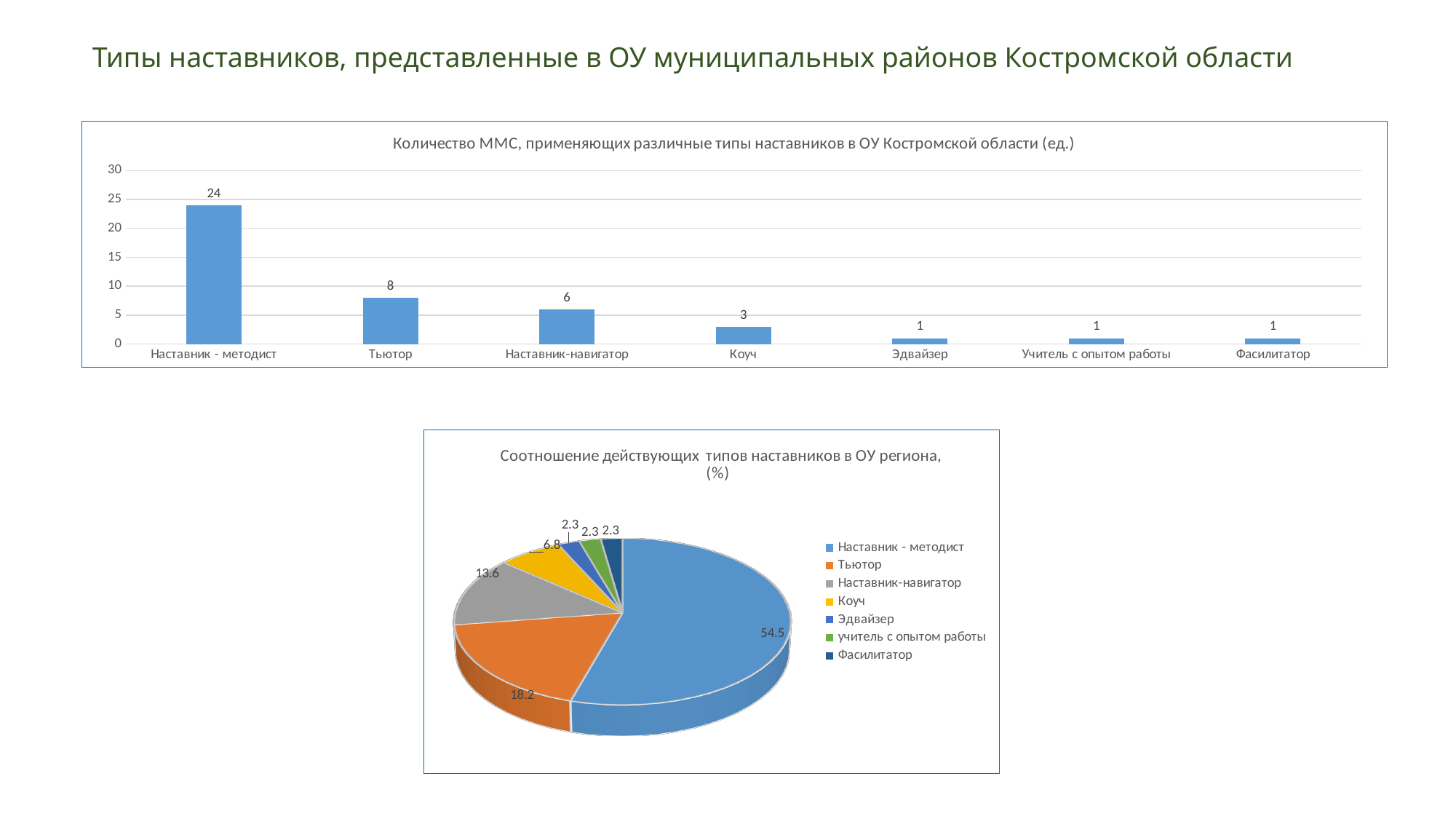
In the top bar chart, do the values rise or fall from left to right along the x axis? fall In the top bar chart, which is larger: Наставник-навигатор or Коуч? Наставник-навигатор In the bottom pie chart, what share does Наставник-навигатор have? 13.6 In the bottom pie chart, what share does Тьютор have? 18.2 In the top bar chart, what is the difference between Наставник - методист and Тьютор? 16 What kind of chart is the top chart on the slide? bar chart In the top bar chart, what is the value for Коуч? 3 In the top bar chart, how many categories are shown on the x axis? 7 In the top bar chart, which category has the highest value? Наставник - методист What is the title of the top bar chart? Количество ММС, применяющих различные типы наставников в ОУ Костромской области (ед.) How many entries does the legend of the bottom pie chart list? 7 In the top bar chart, what is the value for Тьютор? 8